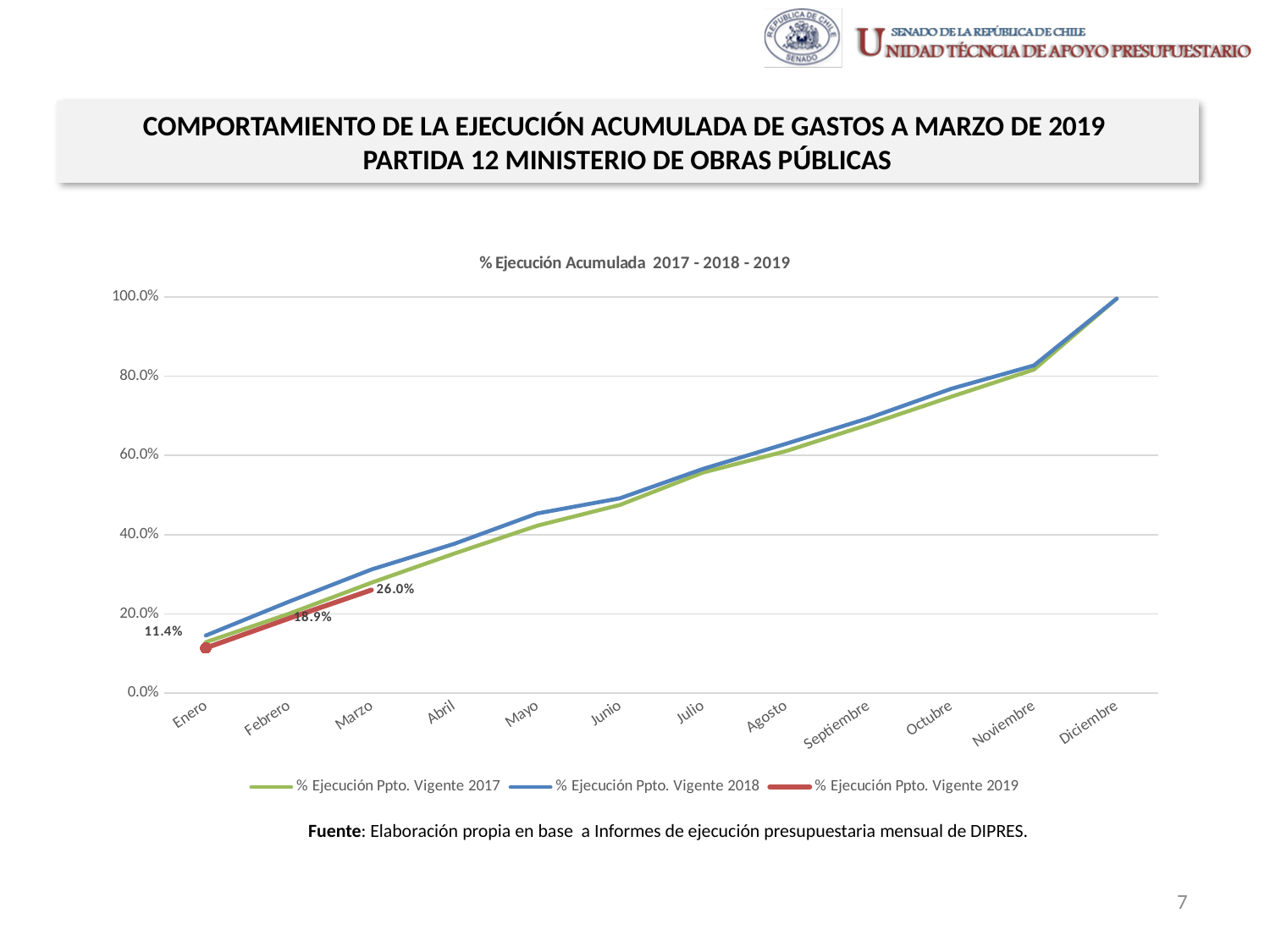
What is the difference between the 2019 values for Febrero and Enero? 7.5% Is the value for % Ejecución Ppto. Vigente 2017 in Abril greater or less than 40.0%? less What kind of chart is shown on the slide? line chart What is the difference between the 2019 values for Marzo and Enero? 14.6% Which month has the highest value for the % Ejecución Ppto. Vigente 2019 series? Marzo What is the value of % Ejecución Ppto. Vigente 2019 for Marzo? 26.0% Is the value for % Ejecución Ppto. Vigente 2018 in Diciembre greater or less than 80.0%? greater How many series does the legend list? 3 How many months are shown on the x axis? 12 What is the value of % Ejecución Ppto. Vigente 2019 for Enero? 11.4% What is the value of % Ejecución Ppto. Vigente 2019 for Febrero? 18.9% Is the 2019 value for Marzo larger or smaller than the 2019 value for Enero? larger